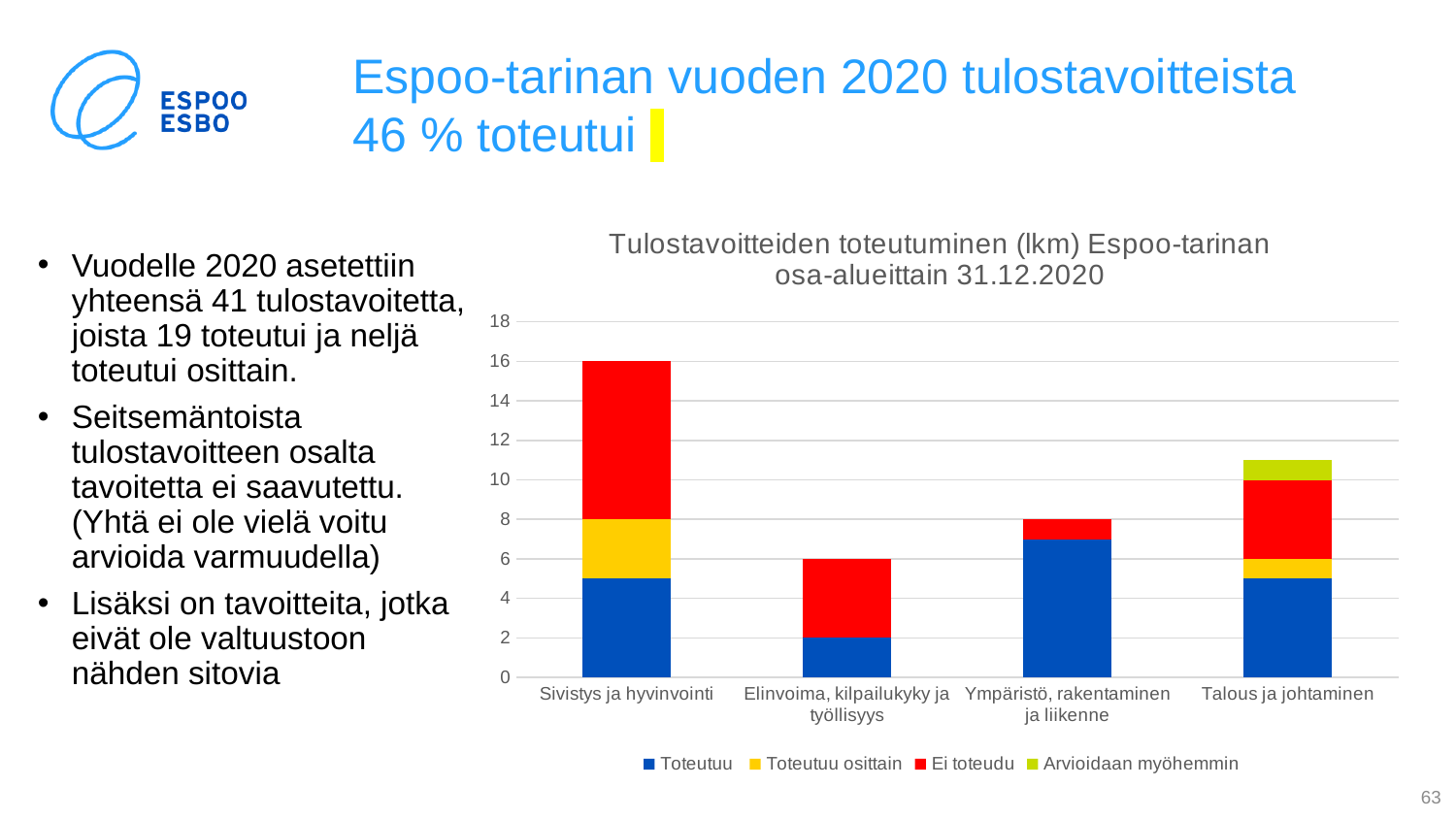
How many series does the legend of the chart list? 4 Is the total for Talous ja johtaminen greater or less than 10? greater What is the total height of the stacked bar for Ympäristö, rakentaminen ja liikenne? 8 Which category is the only one with an Arvioidaan myöhemmin segment? Talous ja johtaminen What is the difference between the total for Sivistys ja hyvinvointi and the total for Elinvoima, kilpailukyky ja työllisyys? 10 How many categories are shown on the x axis of the chart? 4 Which category has the lowest total bar in the chart? Elinvoima, kilpailukyky ja työllisyys Which category has the highest total bar in the chart? Sivistys ja hyvinvointi What kind of chart is shown on the slide? bar chart What is the total height of the stacked bar for Elinvoima, kilpailukyky ja työllisyys? 6 What is the total height of the stacked bar for Sivistys ja hyvinvointi? 16 Which category has the larger Toteutuu segment: Ympäristö, rakentaminen ja liikenne or Elinvoima, kilpailukyky ja työllisyys? Ympäristö, rakentaminen ja liikenne